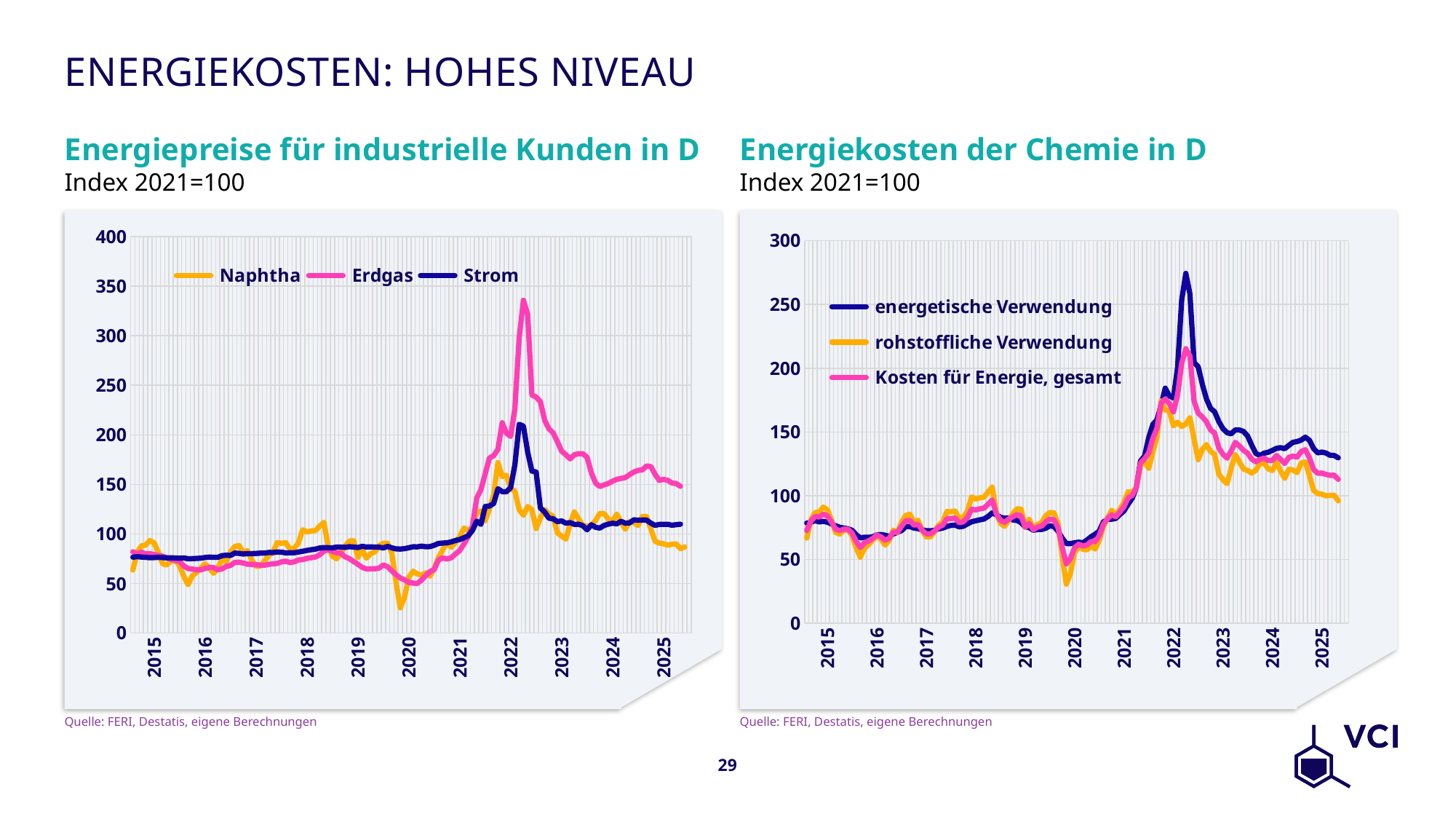
In the left chart 'Energiepreise für industrielle Kunden in D', is the 2022 peak of Erdgas greater or less than 300? greater In the right chart 'Energiekosten der Chemie in D', how many year labels are shown on the x axis? 11 In the left chart 'Energiepreise für industrielle Kunden in D', which series reaches the highest peak in 2022? Erdgas Which series are listed in the legend of the right chart 'Energiekosten der Chemie in D'? energetische Verwendung, rohstoffliche Verwendung, Kosten für Energie, gesamt In the right chart 'Energiekosten der Chemie in D', is the 2022 peak of energetische Verwendung greater or less than 250? greater What kind of chart is the left chart, 'Energiepreise für industrielle Kunden in D'? line chart How many series does the legend of the left chart 'Energiepreise für industrielle Kunden in D' list? 3 In the left chart 'Energiepreise für industrielle Kunden in D', is the 2022 peak of Strom greater or less than 200? greater In the left chart 'Energiepreise für industrielle Kunden in D', which series has the lowest value at the end of 2025? Naphtha In the right chart 'Energiekosten der Chemie in D', which series reaches the highest peak in 2022? energetische Verwendung In the right chart 'Energiekosten der Chemie in D', at the end of 2025, which is higher: energetische Verwendung or rohstoffliche Verwendung? energetische Verwendung